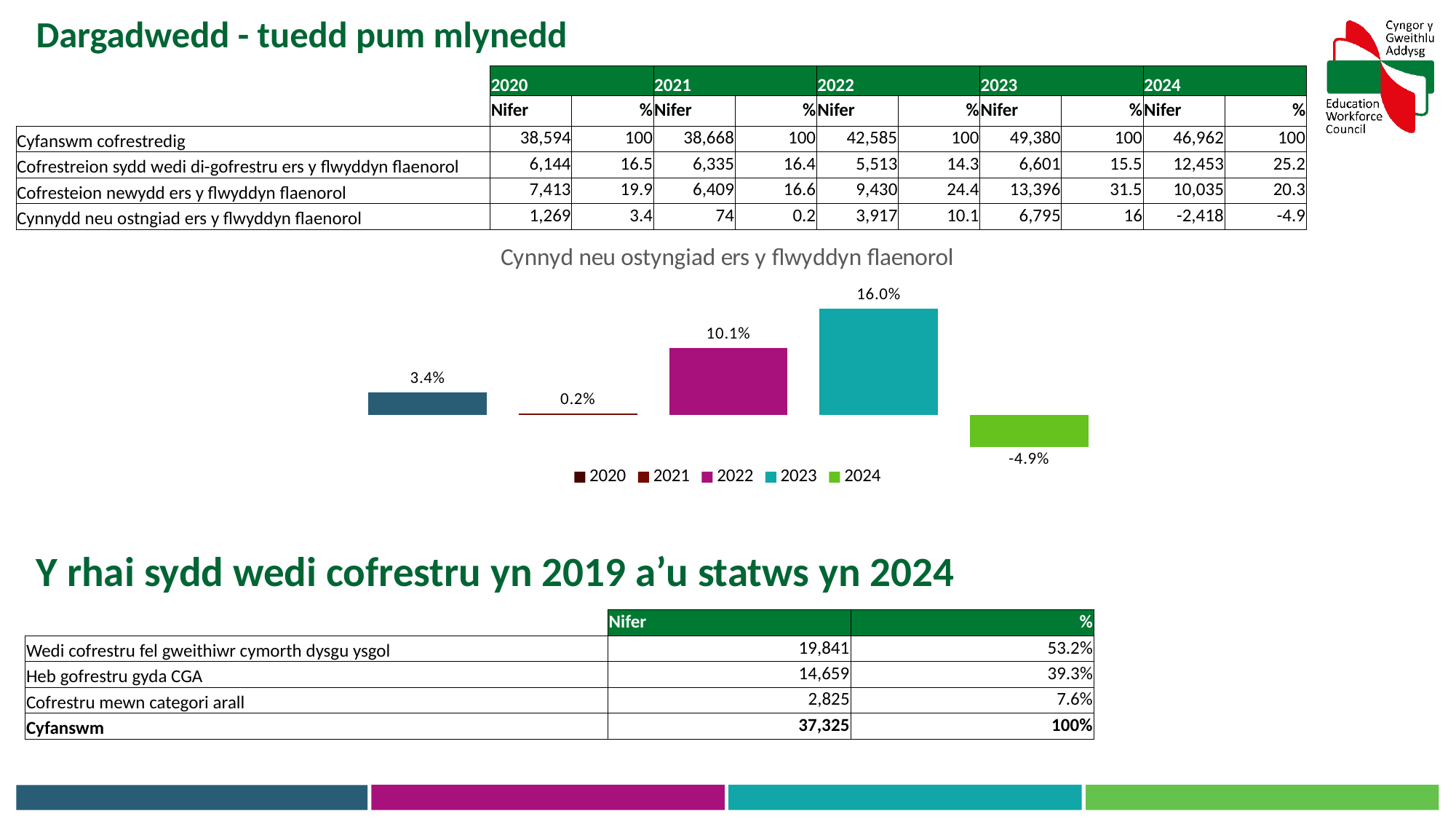
How many entries does the chart's legend list? 5 What kind of chart is shown on the slide? Bar chart What is the value shown for 2023 in the chart? 16.0% How many bars are plotted in the chart? 5 What is the value shown for 2021 in the chart? 0.2% What is the title of the chart? Cynnyd neu ostyngiad ers y flwyddyn flaenorol What is the value shown for 2024 in the chart? -4.9% Which year has the highest value in the chart? 2023 What is the difference between the values for 2023 and 2022 in the chart? 5.9% Which year has the lowest value in the chart? 2024 What is the value shown for 2020 in the chart? 3.4% Which is larger in the chart, the value for 2022 or the value for 2020? 2022